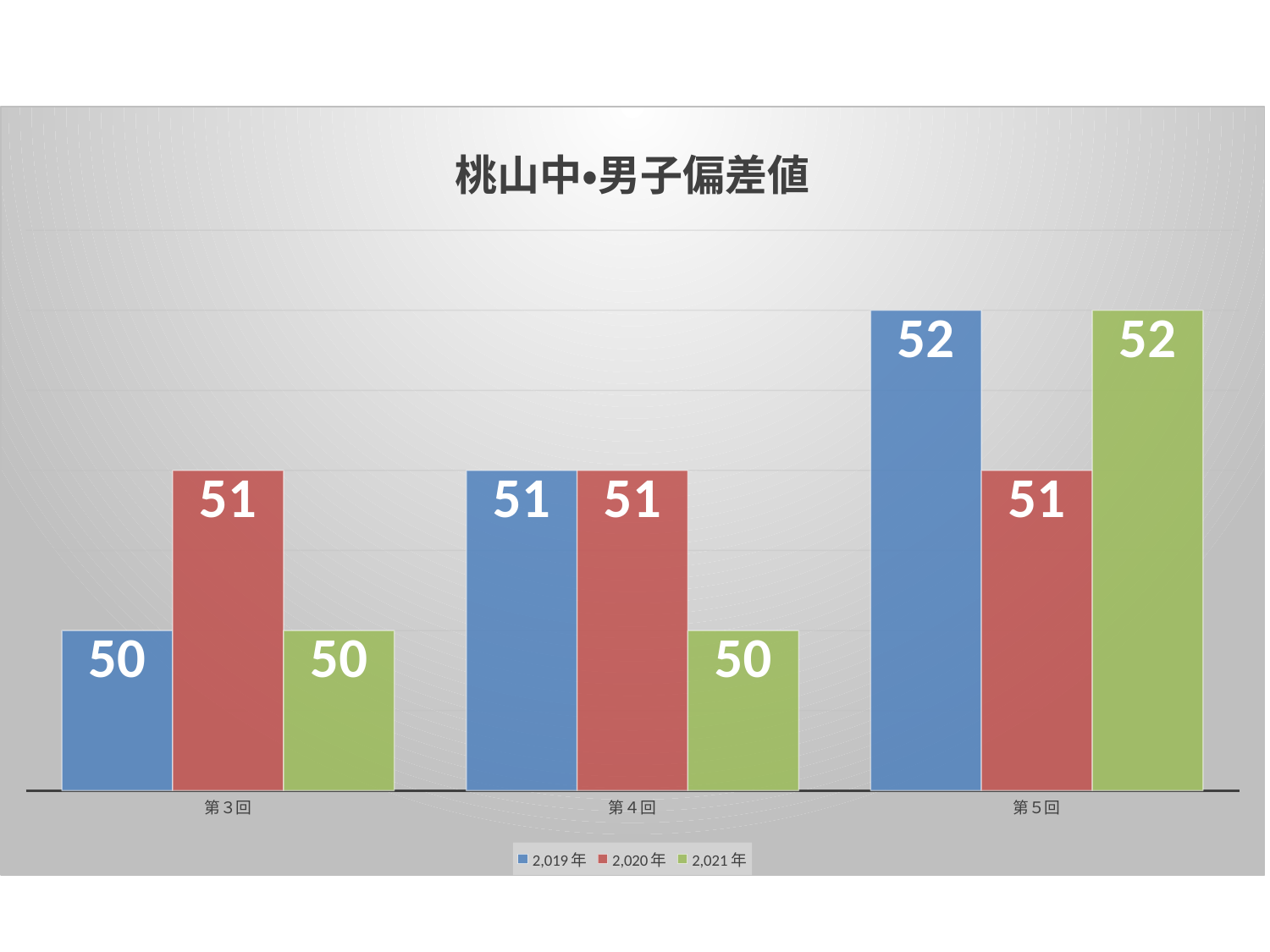
How many series does the legend list? 3 What is the value for 2,020年 at 第3回? 51 What is the value for 2,021年 at 第5回? 52 How many categories are shown on the x axis? 3 What type of chart is shown on the slide? bar chart What is the value for 2,019年 at 第3回? 50 Which category has the highest value for the 2,019年 series? 第5回 Does the value for 2,019年 rise or fall from 第3回 to 第5回? rise What is the title of the chart? 桃山中•男子偏差値 What is the value for 2,021年 at 第4回? 50 Which category has the lowest value for the 2,021年 series? 第3回 and 第4回 (tied at 50) What is the difference between the 2,019年 value at 第5回 and the 2,019年 value at 第3回? 2